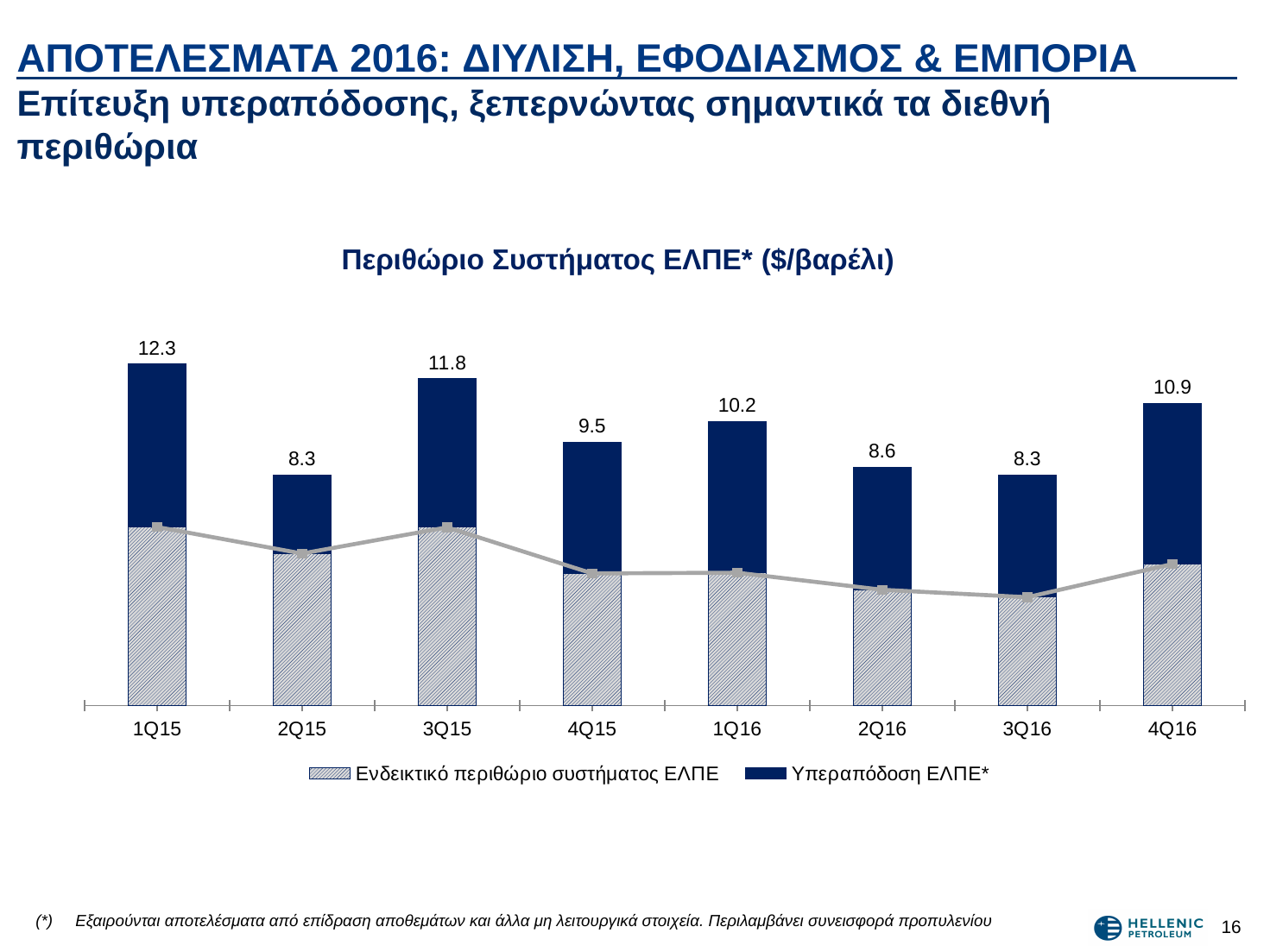
Which has a larger total value, 3Q15 or 4Q15? 3Q15 What is the title of the chart? Περιθώριο Συστήματος ΕΛΠΕ* ($/βαρέλι) What is the total value shown for 4Q16? 10.9 What is the total value shown for 1Q15? 12.3 How many series does the legend list? 2 What is the difference between the total values for 4Q16 and 3Q16? 2.6 What is the difference between the total values for 1Q15 and 2Q15? 4.0 Which quarter has the highest total value? 1Q15 Do the total values rise or fall from 1Q16 to 3Q16? Fall What is the total value shown for 2Q16? 8.6 What kind of chart is shown on the slide? Stacked bar chart with a line How many quarters are shown on the x axis? 8